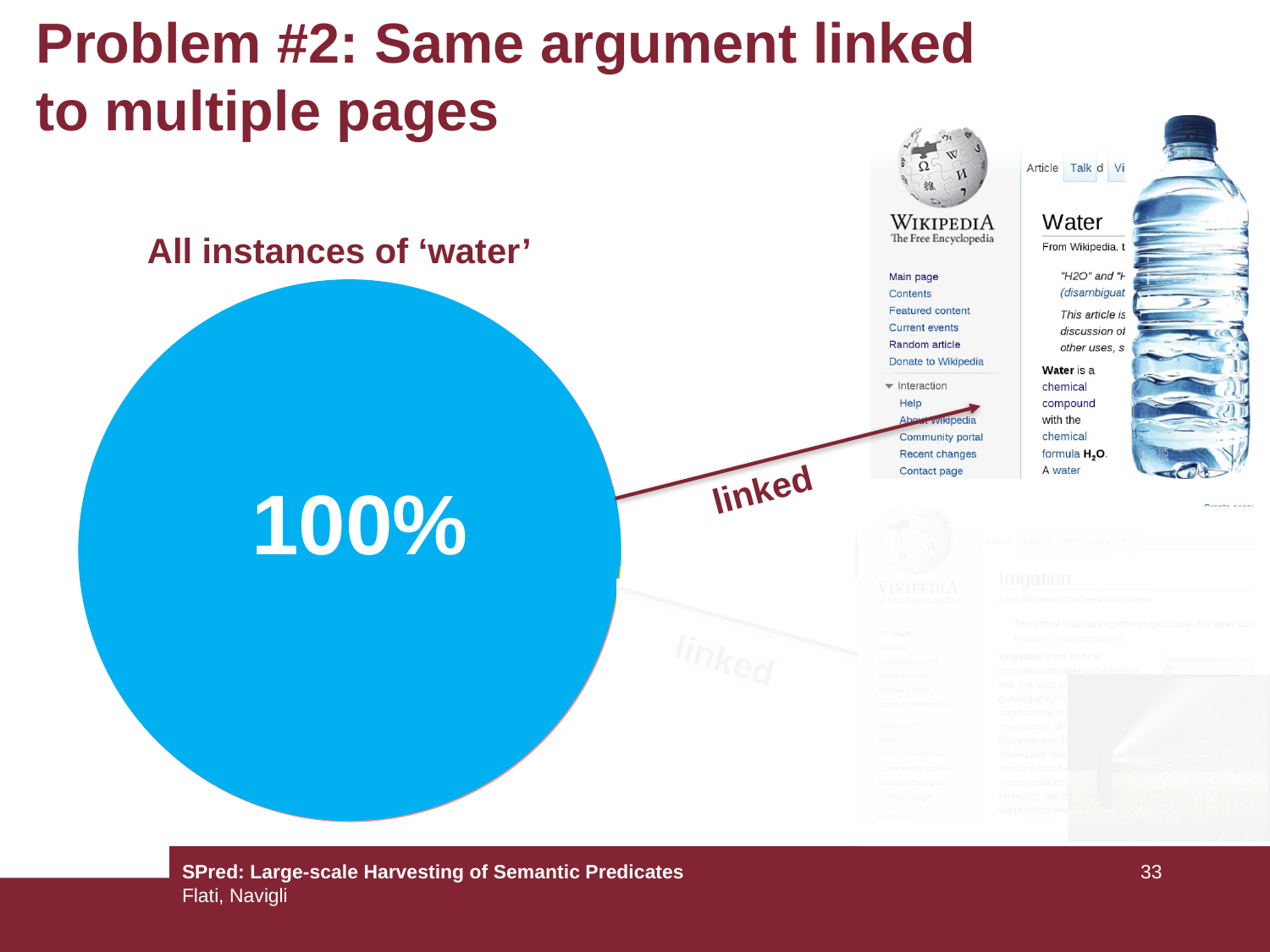
How many slices does the pie chart have? 1 Is the value shown on the pie chart greater or less than 50%? greater What percentage is printed on the pie chart? 100% What colour is the pie chart's slice? blue What share of the pie does the single slice take up? 100% What kind of chart is shown on the slide? pie chart What is the title above the pie chart? All instances of 'water'